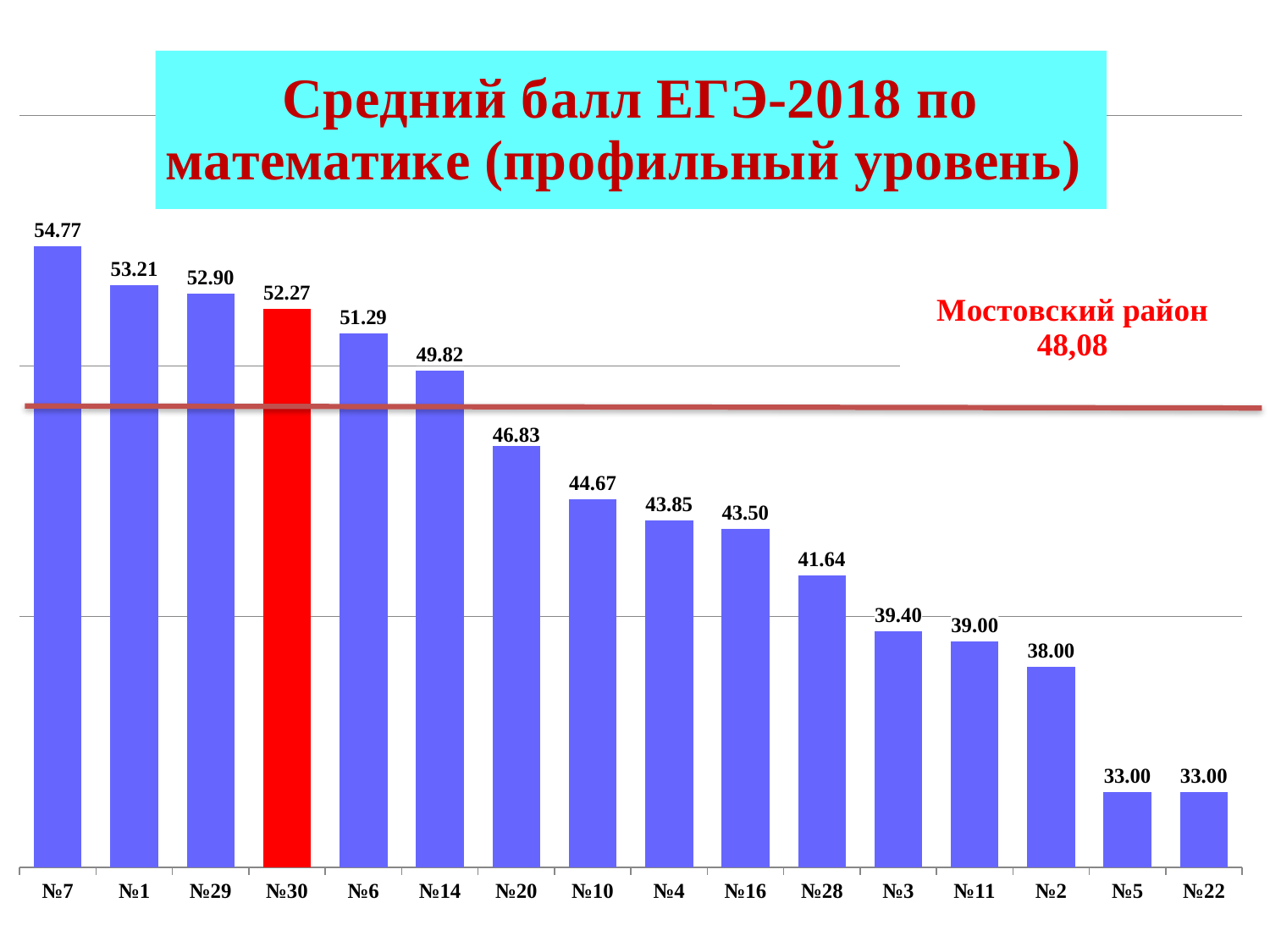
What is the value for №14? 49.82 Which categories share the lowest value? №5 and №22 How many categories are shown on the x axis? 16 What kind of chart is shown on the slide? Bar chart Do the values rise or fall from left to right along the x axis? Fall Which is larger, the value for №20 or the value for №10? №20 What is the value for №30? 52.27 What is the difference between the values for №7 and №22? 21.77 What is the value for №28? 41.64 What is the difference between the values for №30 and №6? 0.98 What is the value for №7? 54.77 Which category has the highest value? №7